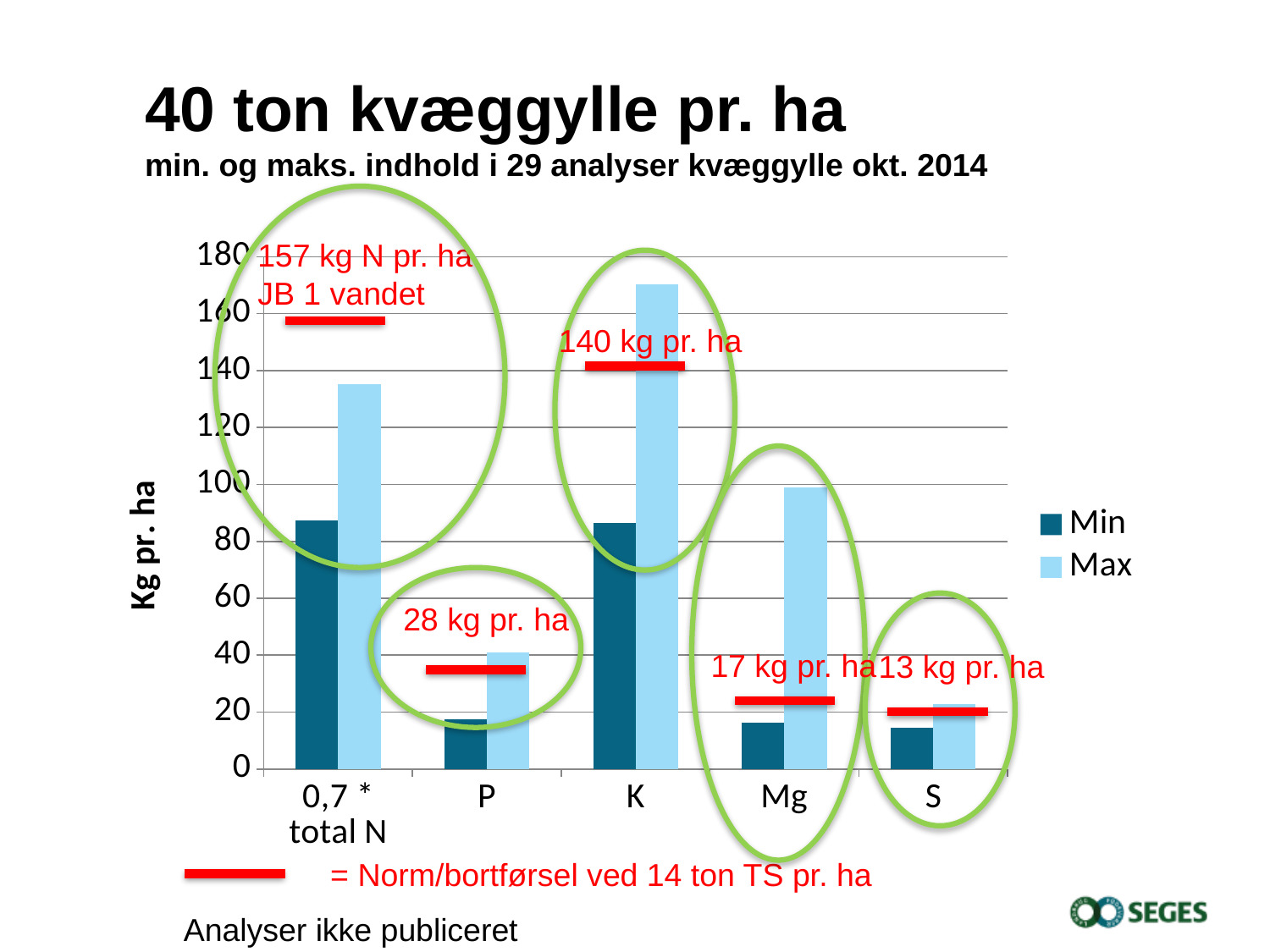
What are the two entries in the legend? Min, Max What kind of chart is shown on the slide? bar chart Is the Max value for K greater or less than 160? greater Which category has the lowest Max value? S Is the Min value for S greater or less than 20? less Is the Max value for Mg greater or less than 80? greater Which category has the highest Max value? K Which is larger, the Max value for P or the Max value for S? P Which is larger, the Max value for K or the Max value for Mg? K How many series does the legend list? 2 How many categories are shown on the x axis? 5